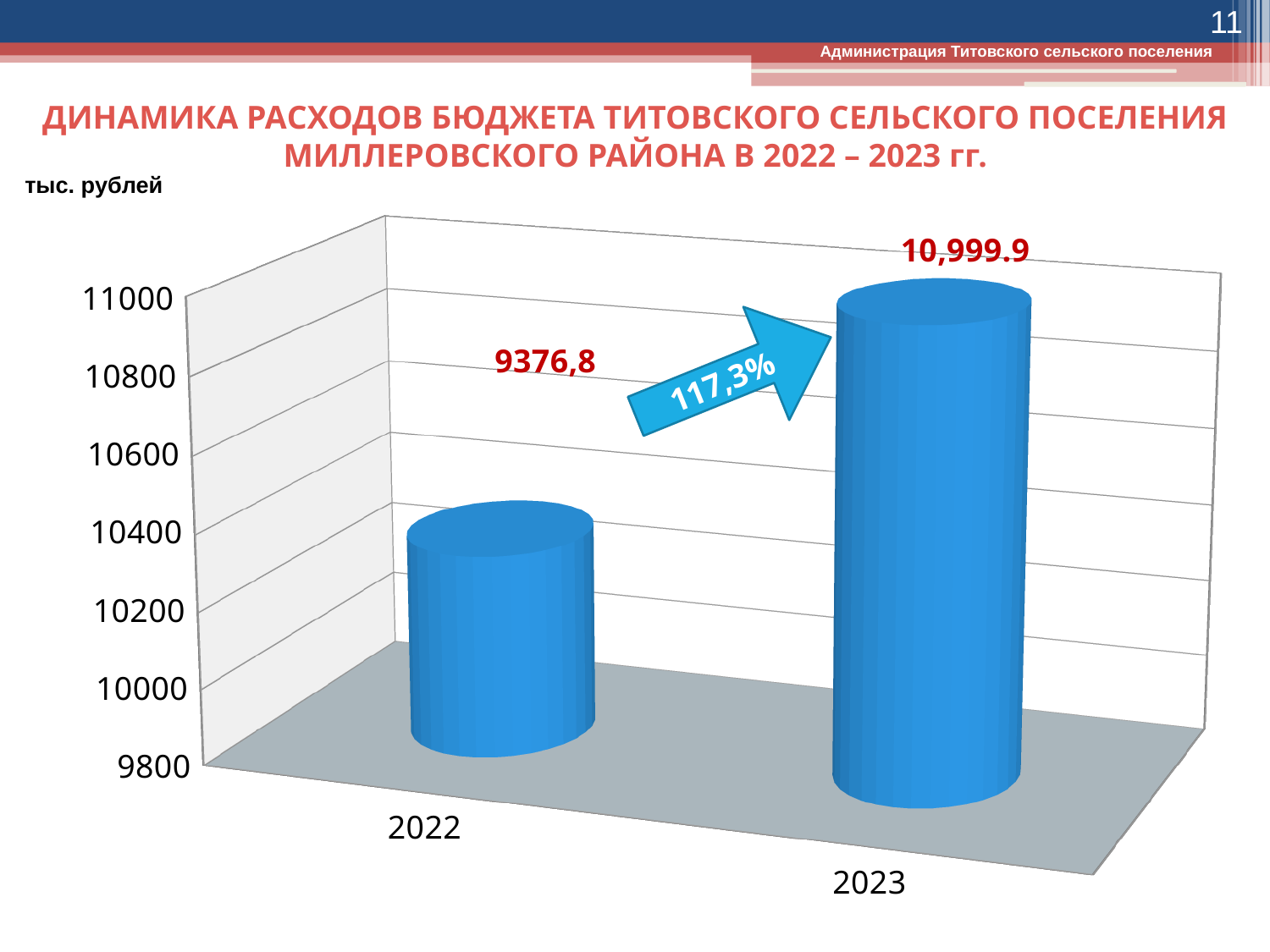
What unit is indicated above the chart? тыс. рублей What percentage is written on the arrow between the two bars? 117,3% Which year has the lowest value? 2022 What kind of chart is shown on the slide? bar chart Is the value for 2023 greater or less than 10800? greater Do the values rise or fall from 2022 to 2023? rise Which year has the highest value? 2023 What is the value for 2022? 9376,8 Which is larger, the value for 2022 or the value for 2023? 2023 What is the value for 2023? 10,999.9 How many years are shown on the chart? 2